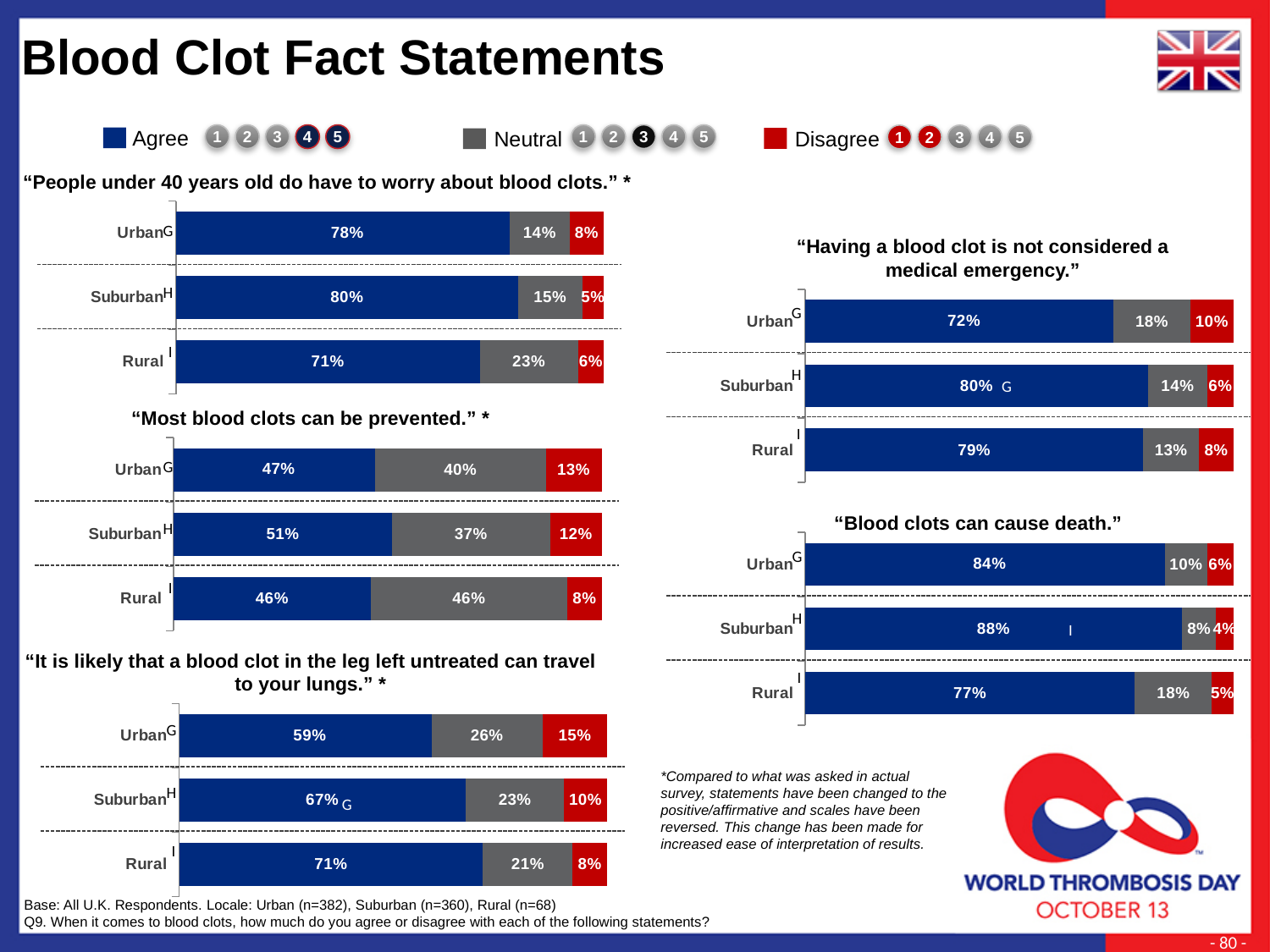
In the chart for "People under 40 years old do have to worry about blood clots," what percentage of Suburban respondents agree? 80% How many locale categories are shown in the chart for "Blood clots can cause death"? 3 In the chart for "It is likely that a blood clot in the leg left untreated can travel to your lungs," which locale has the lowest Agree percentage? Urban In the chart for "Most blood clots can be prevented," what is the Neutral value for Rural respondents? 46% What type of chart is used for "People under 40 years old do have to worry about blood clots"? Stacked bar chart How many series does the legend at the top of the slide list? 3 In the chart for "Blood clots can cause death," which locale has the highest Agree percentage? Suburban In the chart for "Having a blood clot is not considered a medical emergency," what is the difference between the Suburban and Urban Agree percentages? 8% Which colour represents the Disagree series in the legend? Red In the chart for "Most blood clots can be prevented," is the Disagree value larger for Urban or for Rural? Urban In the chart for "Blood clots can cause death," what is the total of the Rural bar (Agree, Neutral and Disagree)? 100% In the chart for "It is likely that a blood clot in the leg left untreated can travel to your lungs," what is the Disagree value for Urban respondents? 15%